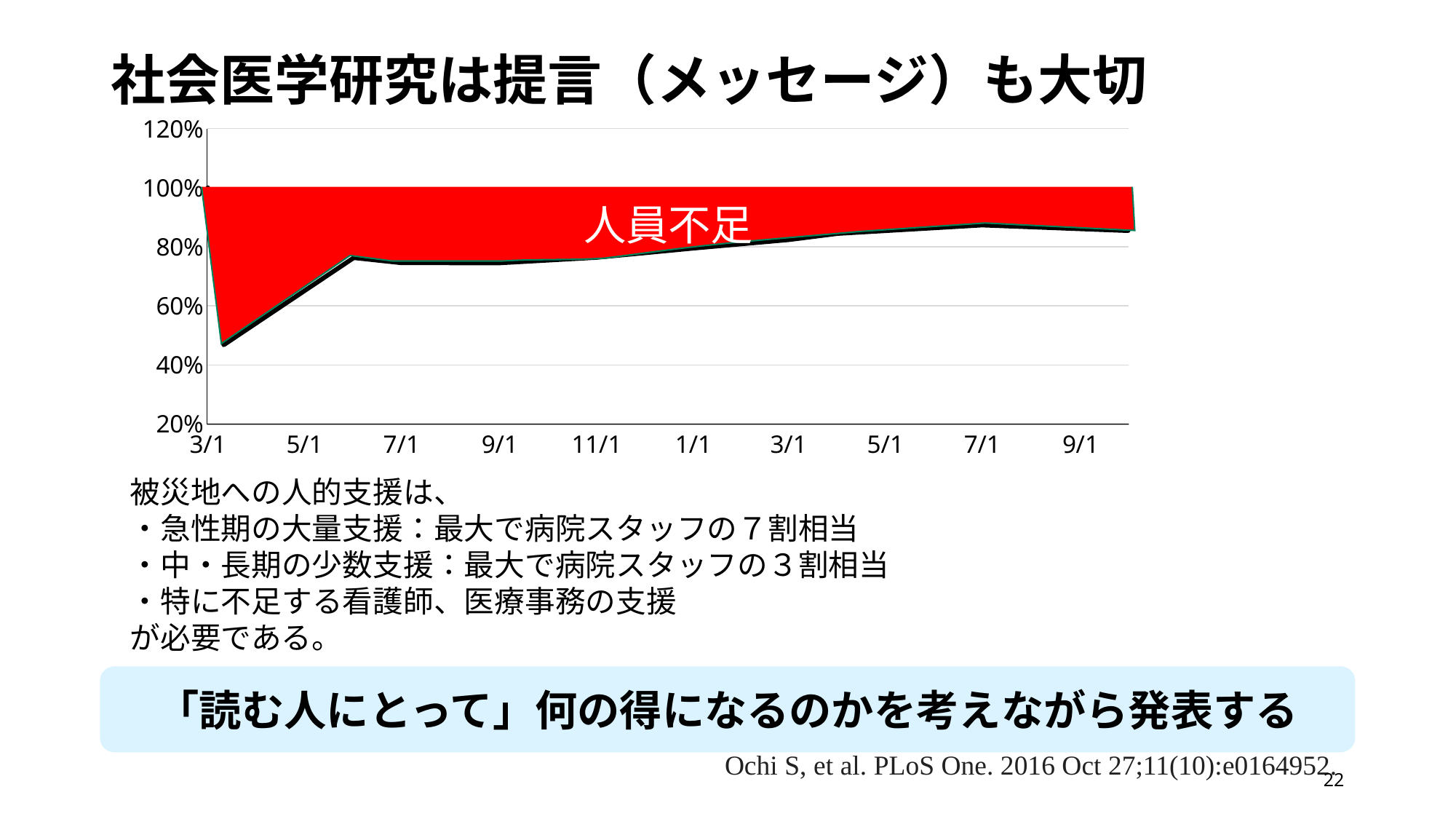
What label is written inside the red shaded area of the chart? 人員不足 Near which x-axis label does the plotted line reach its lowest point? 3/1 (the first one) What is the highest value shown on the y axis of the chart? 120% Is the plotted value at the first 7/1 greater or less than 60%? greater Is the lowest point of the plotted line greater or less than 60%? less Is the plotted value at the second 7/1 greater or less than 80%? greater What kind of chart is shown on the slide? line chart Does the plotted line rise or fall between the first 9/1 and the second 7/1? rise Which is larger, the plotted value at the first 5/1 or at the second 5/1? the second 5/1 How many date labels are shown along the x axis of the chart? 10